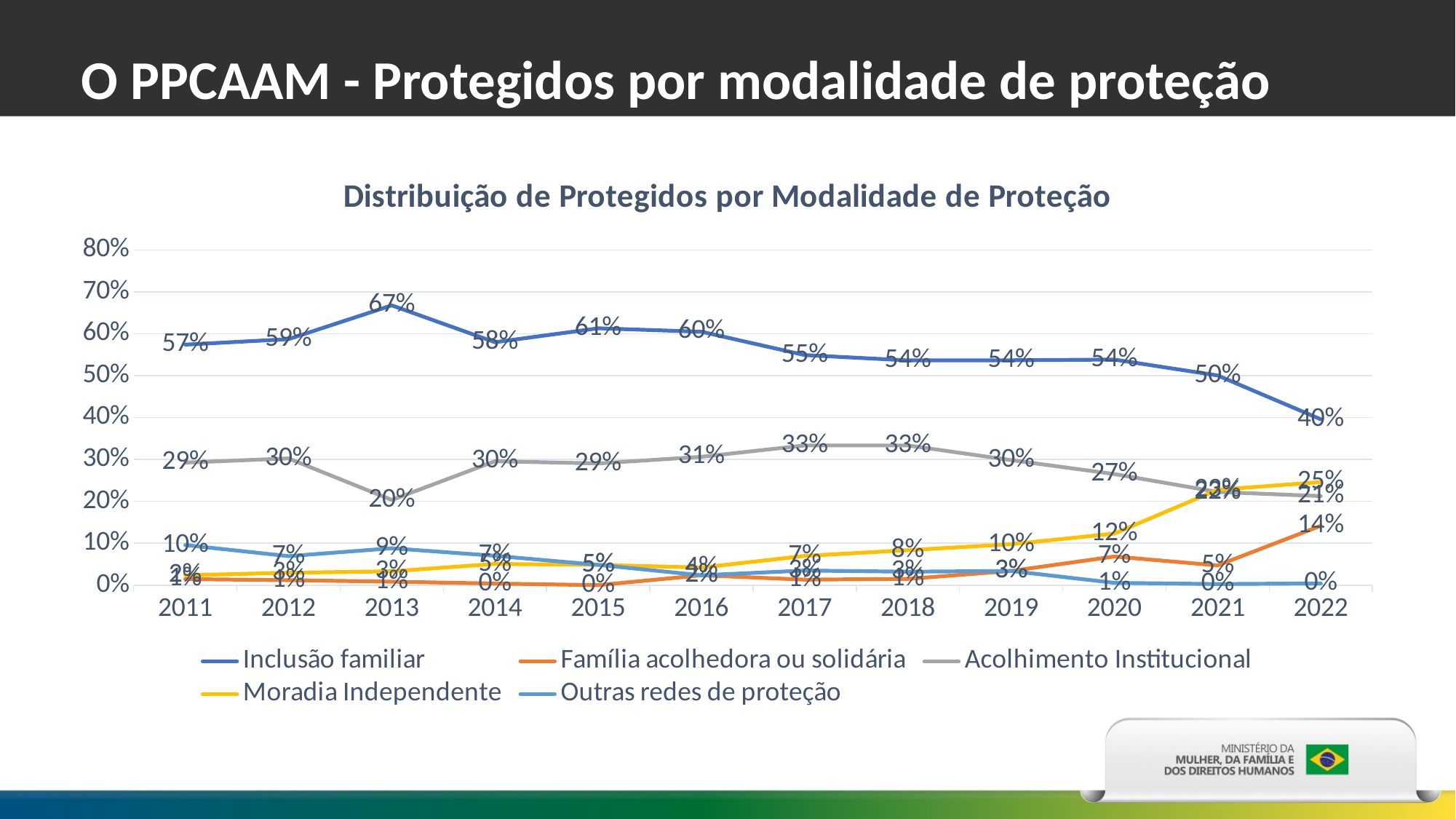
What is the value for Moradia Independente in 2022? 25% What is the value for Família acolhedora ou solidária in 2022? 14% What is the value for Acolhimento Institucional in 2020? 27% In 2022, which is larger: Moradia Independente or Acolhimento Institucional? Moradia Independente By how many percentage points did Inclusão familiar fall from 2013 to 2022? 27 percentage points In which year does Inclusão familiar reach its lowest value? 2022 What is the value for Inclusão familiar in 2013? 67% How many series does the legend list? 5 In which year does Inclusão familiar reach its highest value? 2013 Does the Inclusão familiar line rise or fall from 2016 to 2022? Fall What type of chart is shown on the slide? Line chart How many years are plotted along the x axis? 12